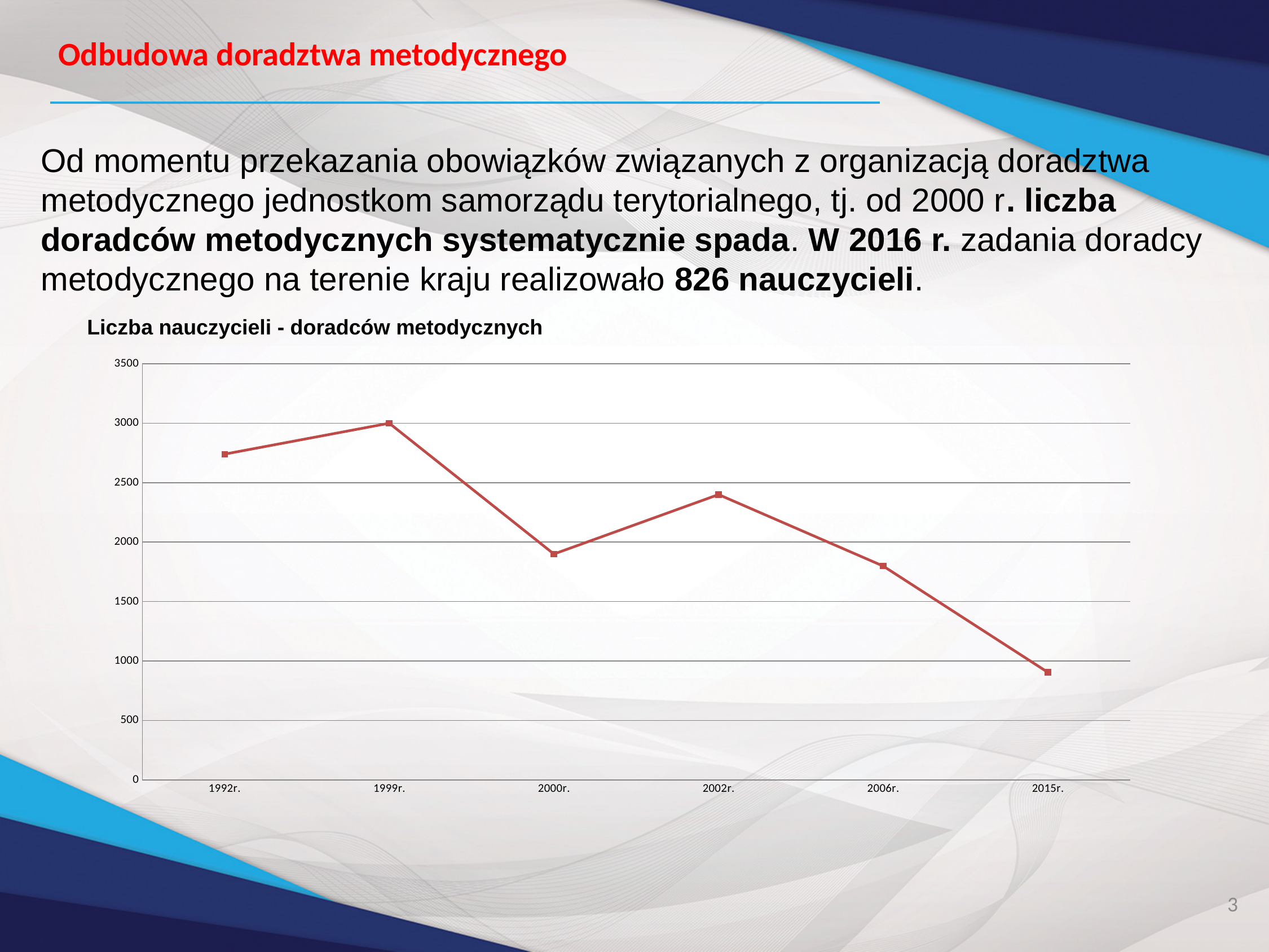
What is the title of the chart? Liczba nauczycieli - doradców metodycznych How many years are plotted on the x axis of the chart? 6 Is the value for 1992r. greater or less than 2500? greater Which is larger, the value for 1992r. or the value for 2000r.? 1992r. Does the value rise or fall between 2006r. and 2015r.? fall Is the value for 2015r. greater or less than 1000? less What kind of chart is shown on the slide? line chart Is the value for 2002r. greater or less than 2000? greater Which year has the highest value in the chart? 1999r. Which year has the lowest value in the chart? 2015r.